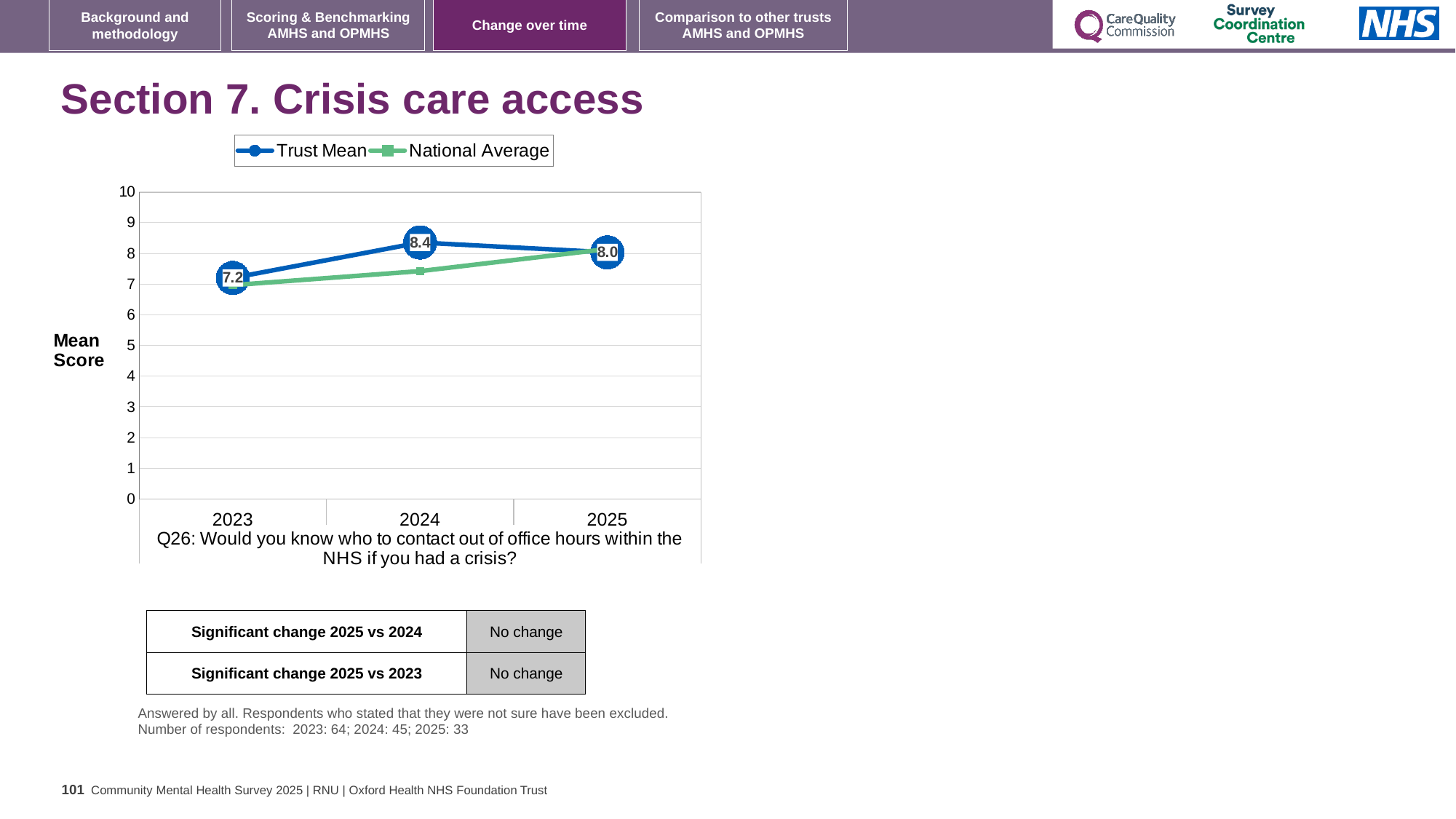
Is the National Average value for 2024 greater or less than 8? less What is the Trust Mean score for 2024? 8.4 What is the Trust Mean score for 2023? 7.2 How many series does the legend list? 2 In 2024, which series has the higher value, Trust Mean or National Average? Trust Mean What kind of chart is shown on the slide? Line chart In which year is the Trust Mean score lowest? 2023 In which year is the Trust Mean score highest? 2024 What is the difference between the Trust Mean scores for 2024 and 2025? 0.4 What is the difference between the Trust Mean scores for 2024 and 2023? 1.2 What is the Trust Mean score for 2025? 8.0 How many years are plotted on the x axis? 3